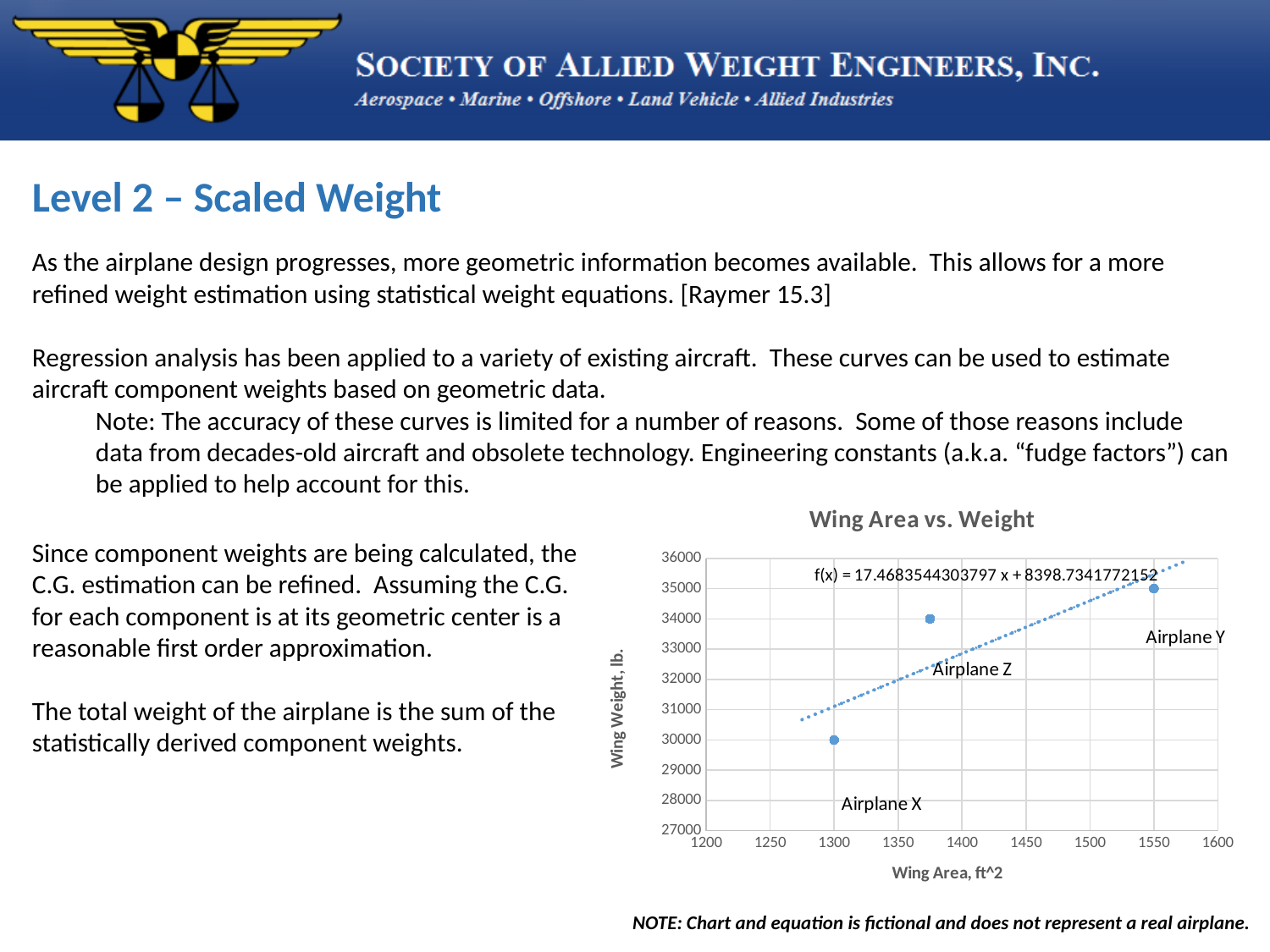
What is the wing area of Airplane Y in ft^2? 1550 Is the wing area of Airplane Z greater or less than 1350 ft^2? greater What is the wing weight of Airplane X in lb.? 30000 What is the difference in wing weight between Airplane Y and Airplane X, in lb.? 5000 Does wing weight generally rise or fall as wing area increases along the x axis? Rise What is the label of the y axis? Wing Weight, lb. Which airplane has the highest wing weight? Airplane Y How many airplane data points are plotted on the chart? 3 What is the title of the chart? Wing Area vs. Weight What kind of chart is shown on the slide? Scatter chart Which has a higher wing weight, Airplane Z or Airplane X? Airplane Z Which airplane has the lowest wing weight? Airplane X